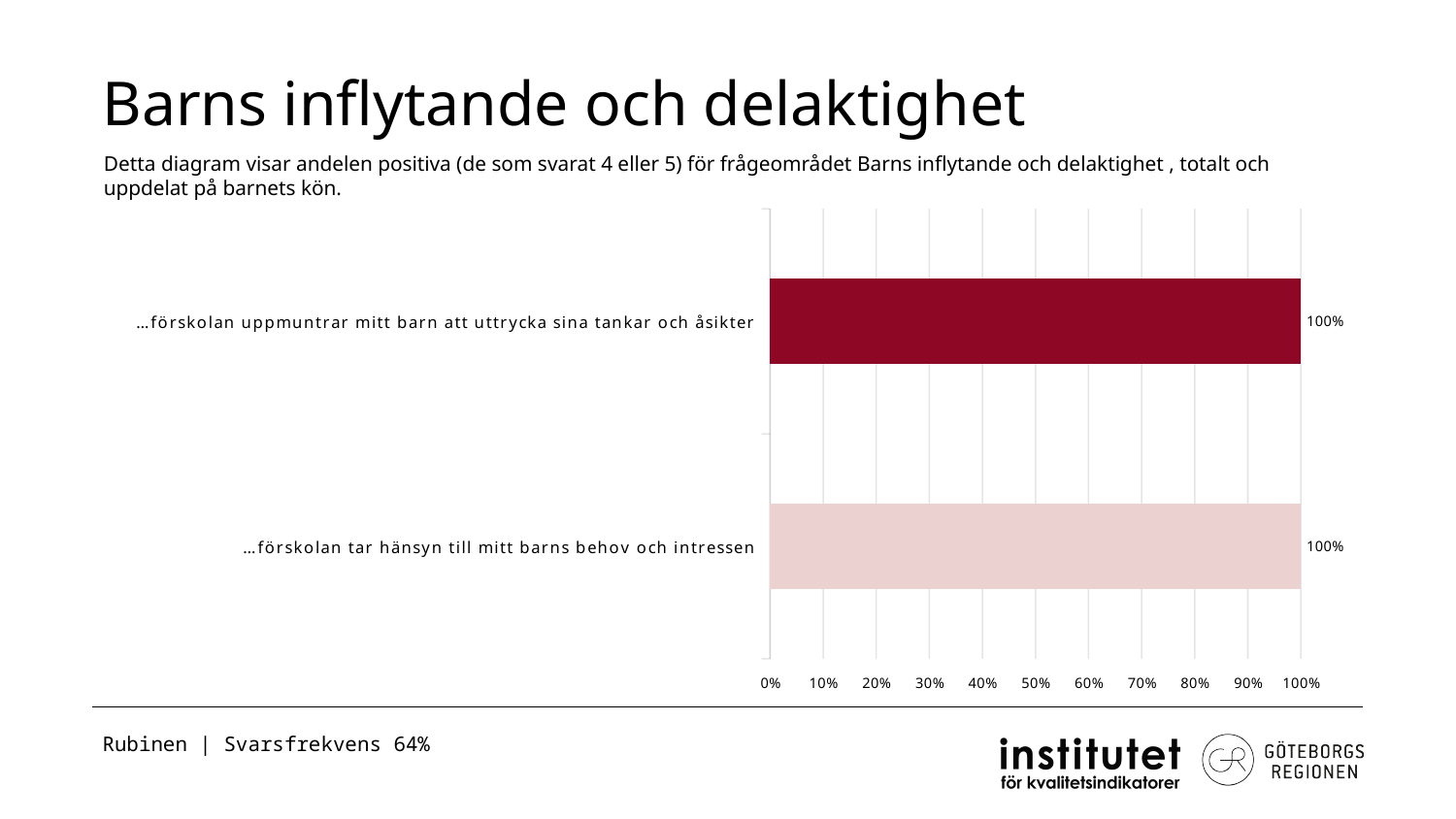
What is the difference between the values for "…förskolan uppmuntrar mitt barn att uttrycka sina tankar och åsikter" and "…förskolan tar hänsyn till mitt barns behov och intressen"? 0% Is the value for "…förskolan tar hänsyn till mitt barns behov och intressen" greater or less than 50%? greater How many categories are plotted in the chart? 2 Do the two categories have the same value? Yes, both are 100% What is the value for "…förskolan uppmuntrar mitt barn att uttrycka sina tankar och åsikter"? 100% Is the value for "…förskolan uppmuntrar mitt barn att uttrycka sina tankar och åsikter" greater or less than 90%? greater What is the value for "…förskolan tar hänsyn till mitt barns behov och intressen"? 100% What kind of chart is shown on the slide? Bar chart What is the title of the slide containing the chart? Barns inflytande och delaktighet What is the highest tick label shown on the x axis? 100%